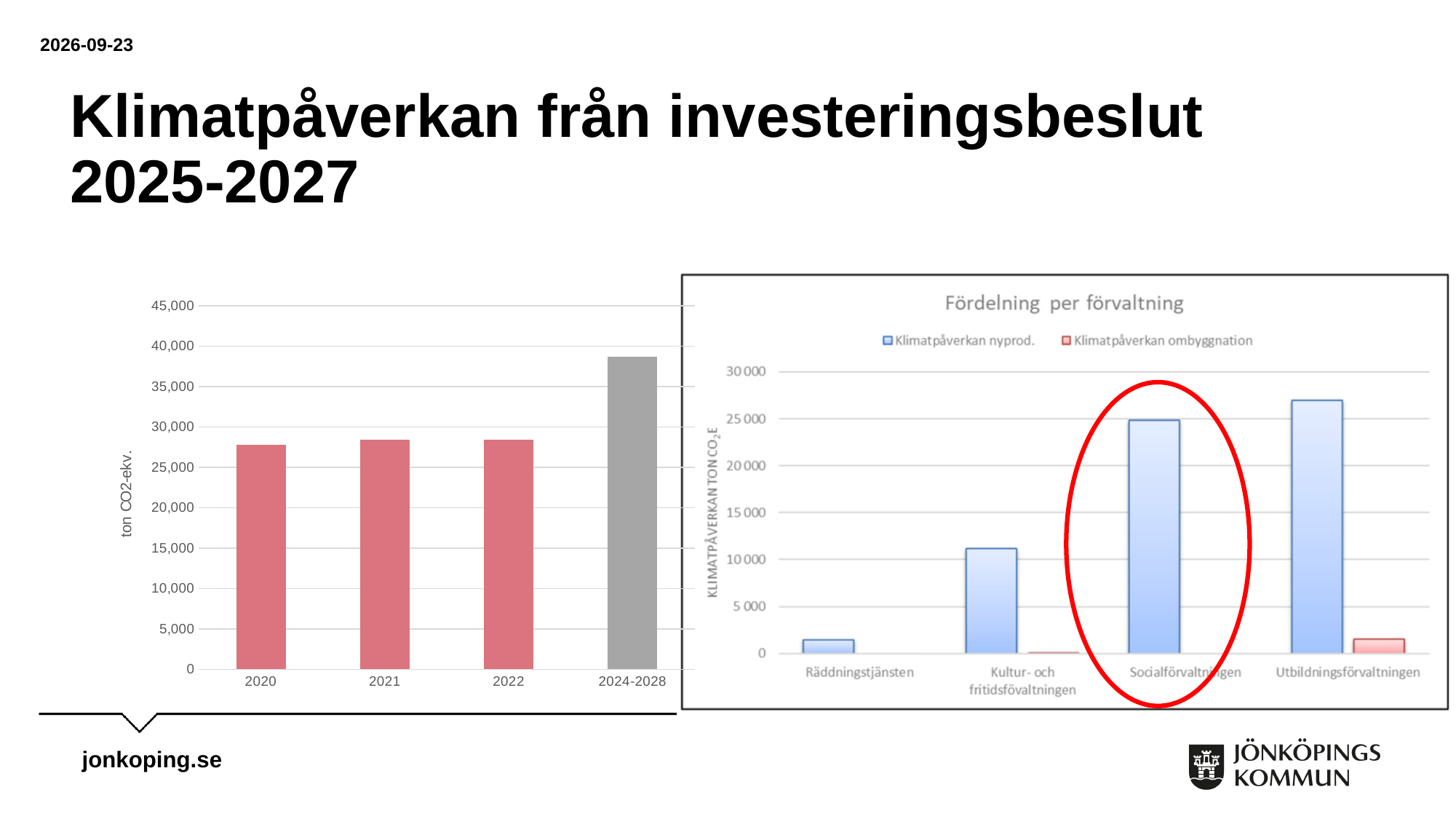
What kind of chart is the left chart? bar chart On the left chart, how many categories are shown on the x axis? 4 On the 'Fördelning per förvaltning' chart, which is larger for Utbildningsförvaltningen: Klimatpåverkan nyprod. or Klimatpåverkan ombyggnation? Klimatpåverkan nyprod. On the 'Fördelning per förvaltning' chart, how many series does the legend list? 2 On the left chart, which category has the highest value? 2024-2028 On the 'Fördelning per förvaltning' chart, which förvaltning has the highest value for Klimatpåverkan nyprod.? Utbildningsförvaltningen On the 'Fördelning per förvaltning' chart, which förvaltning has the lowest value for Klimatpåverkan nyprod.? Räddningstjänsten On the 'Fördelning per förvaltning' chart, is the Klimatpåverkan nyprod. value for Räddningstjänsten greater or less than 5 000? less On the left chart, is the value for 2024-2028 greater or less than 35,000? greater On the left chart, is the value for 2020 greater or less than 30,000? less On the left chart, what is the y-axis label? ton CO2-ekv.